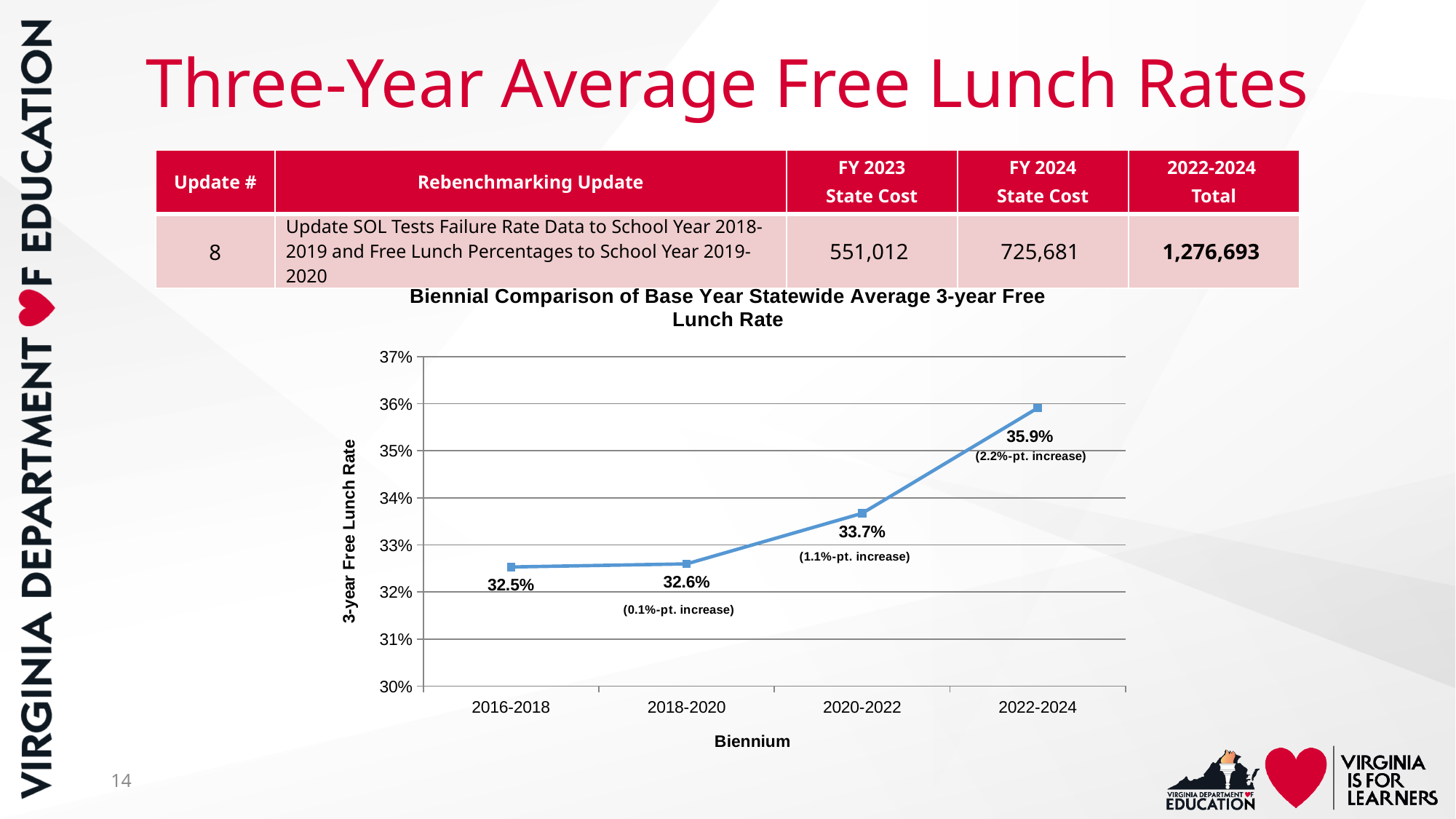
How many biennia are plotted on the chart? 4 What is the difference in the 3-year free lunch rate between 2018-2020 and 2016-2018? 0.1 percentage points What is the difference in the 3-year free lunch rate between 2022-2024 and 2020-2022? 2.2 percentage points What type of chart is used to show the biennial comparison of the free lunch rate? Line chart Which biennium has the lowest 3-year free lunch rate? 2016-2018 Is the 3-year free lunch rate for 2022-2024 greater or less than 35%? greater Which biennium has the highest 3-year free lunch rate? 2022-2024 What is the 3-year free lunch rate for the 2016-2018 biennium? 32.5% Does the 3-year free lunch rate rise or fall from 2016-2018 to 2022-2024? Rise Which biennium has a higher 3-year free lunch rate, 2018-2020 or 2020-2022? 2020-2022 What is the 3-year free lunch rate for the 2020-2022 biennium? 33.7% What is the 3-year free lunch rate for the 2022-2024 biennium? 35.9%